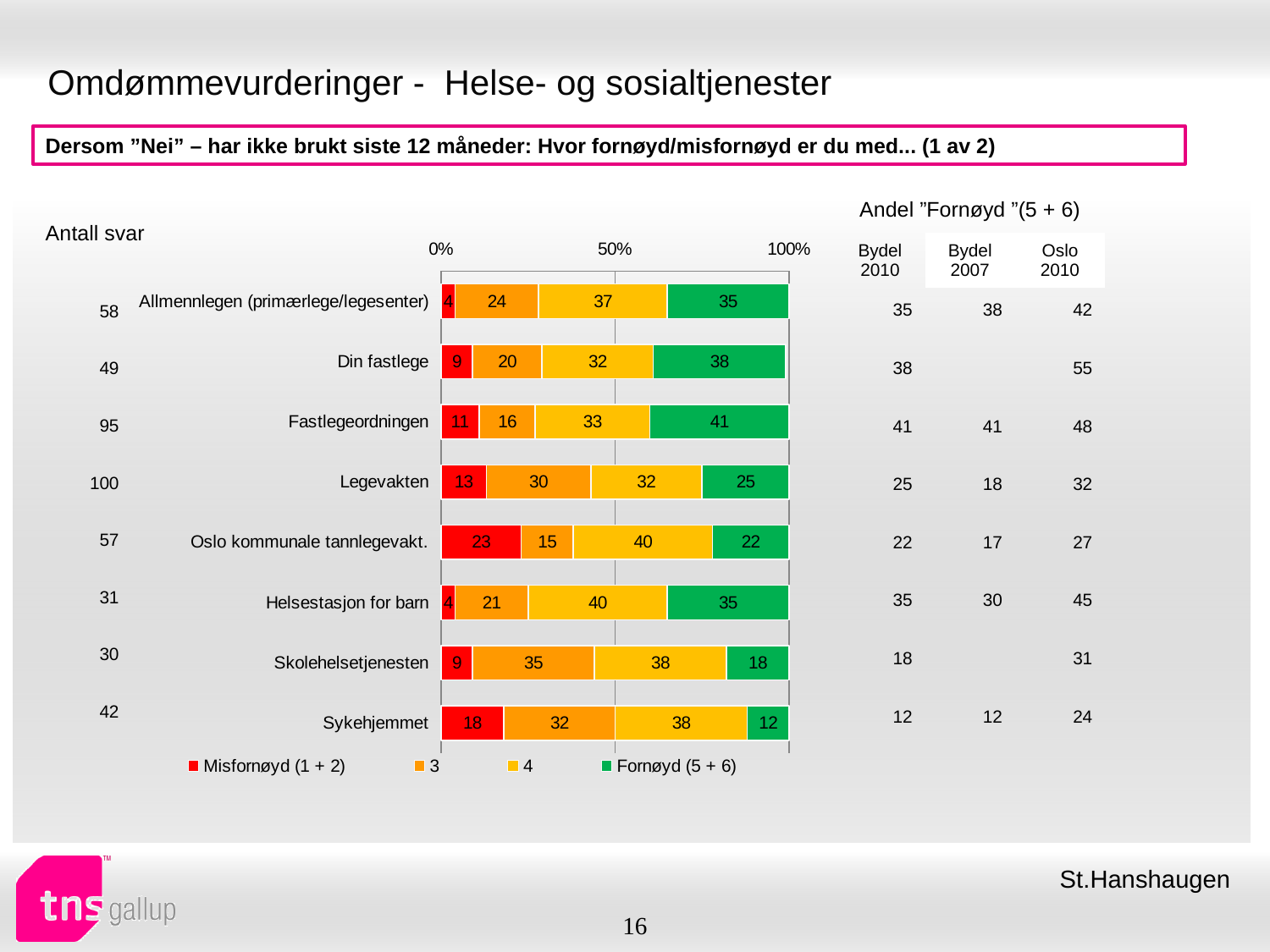
Which category has the highest "Fornøyd (5 + 6)" value? Fastlegeordningen What is the value of series "3" for Skolehelsetjenesten? 35 How many series does the chart legend list? 4 What is the "Misfornøyd (1 + 2)" value for Oslo kommunale tannlegevakt.? 23 How many categories (services) are plotted in the bar chart? 8 What is the total of the stacked bar for Allmennlegen (primærlege/legesenter)? 100 What is the difference between the "Fornøyd (5 + 6)" values for Din fastlege and Legevakten? 13 Which has a larger "Misfornøyd (1 + 2)" value: Sykehjemmet or Legevakten? Sykehjemmet Which colour represents the "Fornøyd (5 + 6)" series in the chart? Green What kind of chart is shown on the slide? Stacked bar chart Which category has the lowest "Fornøyd (5 + 6)" value? Sykehjemmet What is the "Fornøyd (5 + 6)" value for Fastlegeordningen? 41